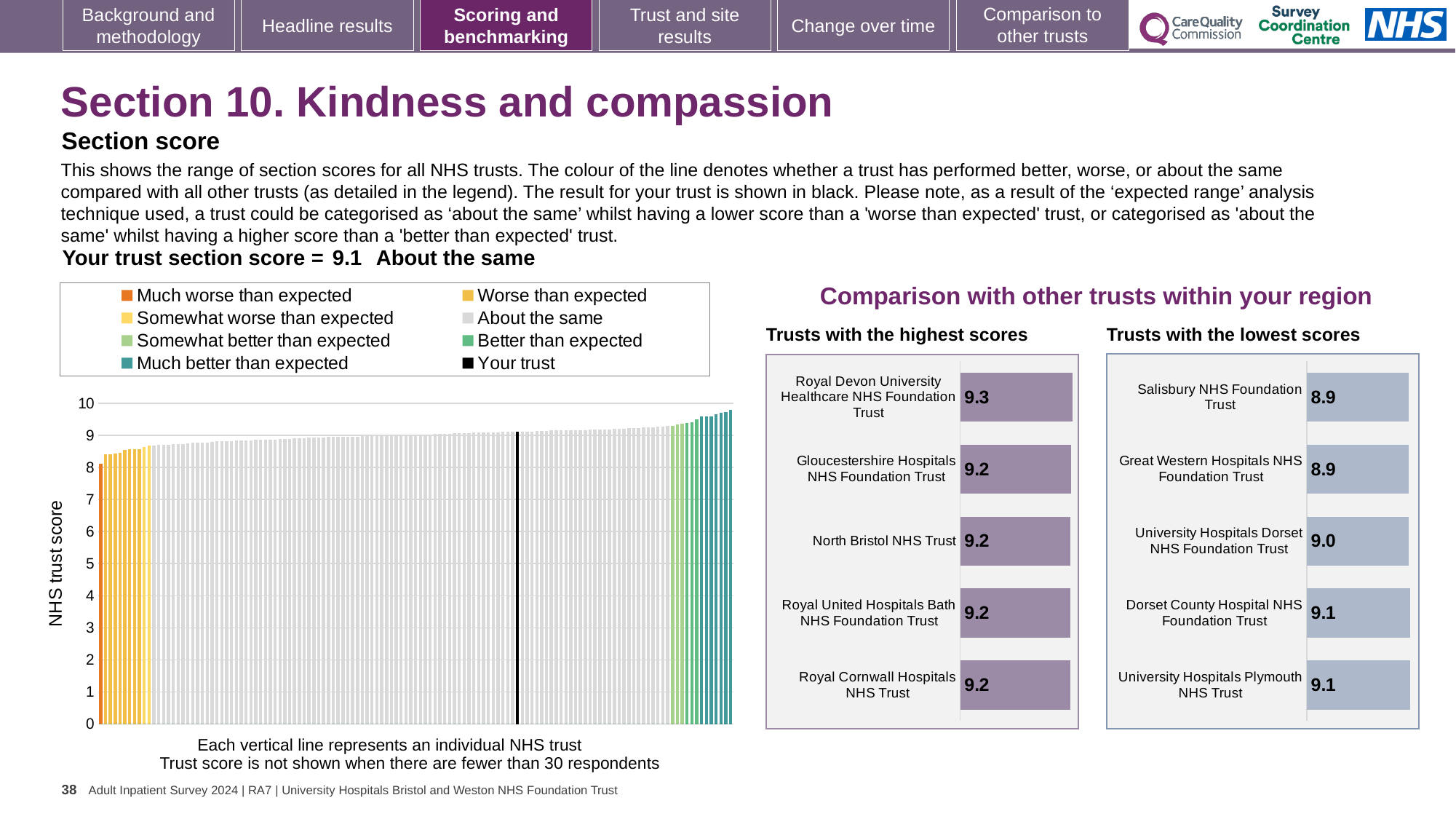
In the 'Trusts with the highest scores' chart, which trust has the highest score? Royal Devon University Healthcare NHS Foundation Trust In the 'Trusts with the highest scores' chart, what is the difference between the scores of Royal Devon University Healthcare NHS Foundation Trust and North Bristol NHS Trust? 0.1 In the large chart on the left, what is the label on the vertical axis? NHS trust score In the large chart on the left, is the value for the leftmost (orange) trust greater or less than 7? greater What kind of chart is the large chart on the left showing the range of section scores for all NHS trusts? bar chart How many entries does the legend above the large chart on the left list? 8 What is the section score for your trust, shown as the black line in the large chart on the left? 9.1 In the large chart on the left, do the trust scores rise or fall from left to right along the x axis? rise In the 'Trusts with the lowest scores' chart, what is the score for University Hospitals Dorset NHS Foundation Trust? 9.0 In the 'Trusts with the highest scores' chart, what is the score for Royal Devon University Healthcare NHS Foundation Trust? 9.3 In the 'Trusts with the lowest scores' chart, which has the larger score: Dorset County Hospital NHS Foundation Trust or Salisbury NHS Foundation Trust? Dorset County Hospital NHS Foundation Trust In the 'Trusts with the highest scores' chart, how many trusts are shown? 5